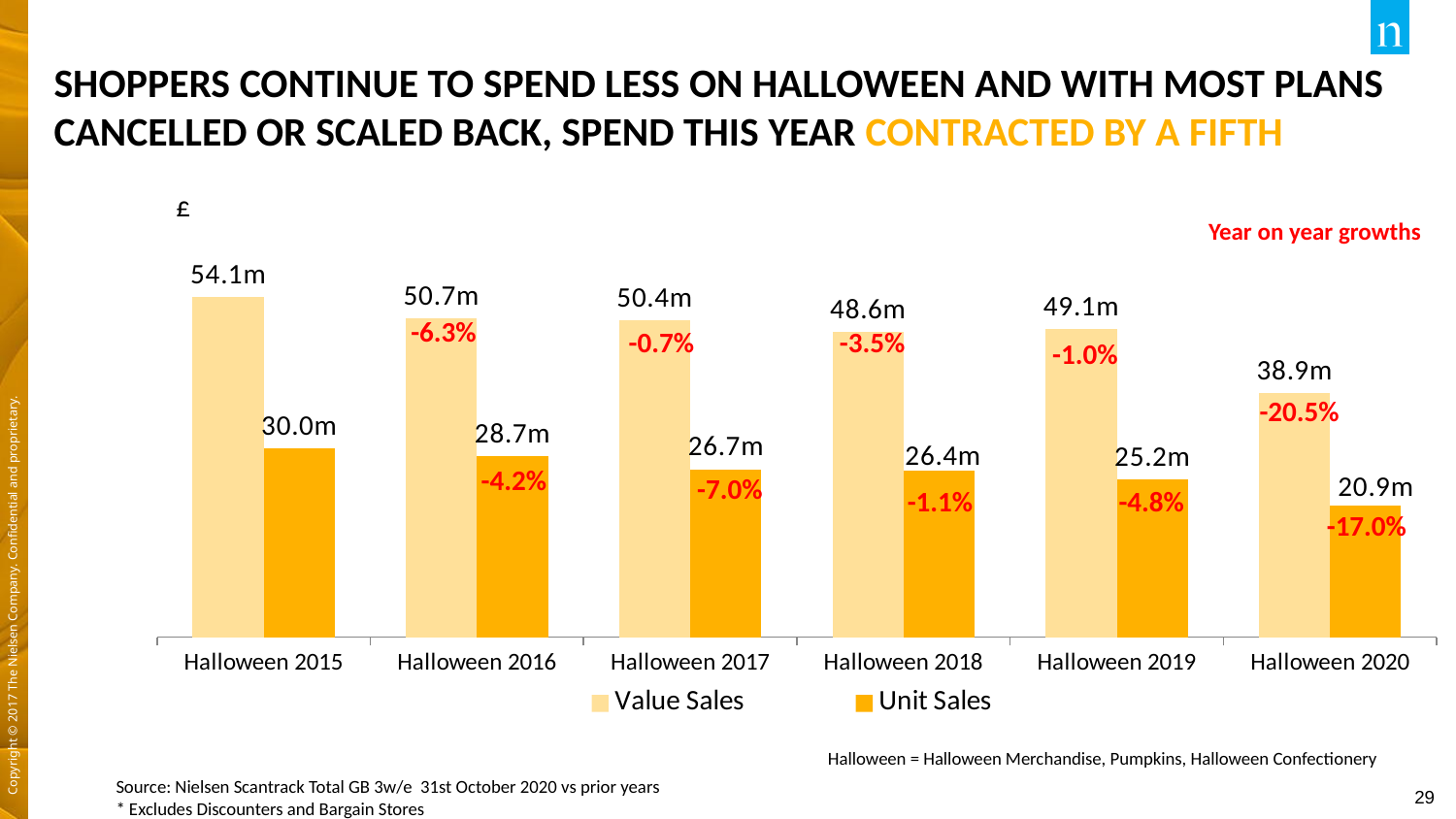
Which Halloween year has the lowest Unit Sales? Halloween 2020 Do Unit Sales rise or fall from Halloween 2015 to Halloween 2020? Fall What kind of chart is shown on the slide? Bar chart What is the difference between Value Sales for Halloween 2019 and Halloween 2020? 10.2m Which Halloween year has the highest Value Sales? Halloween 2015 What year-on-year growth is shown for Value Sales at Halloween 2020? -20.5% How many series does the legend list? 2 What is the Unit Sales figure for Halloween 2020? 20.9m Which is larger, Value Sales for Halloween 2018 or Value Sales for Halloween 2019? Halloween 2019 What is the Value Sales figure for Halloween 2015? 54.1m How many Halloween years are shown on the x axis? 6 What year-on-year growth is shown for Unit Sales at Halloween 2017? -7.0%